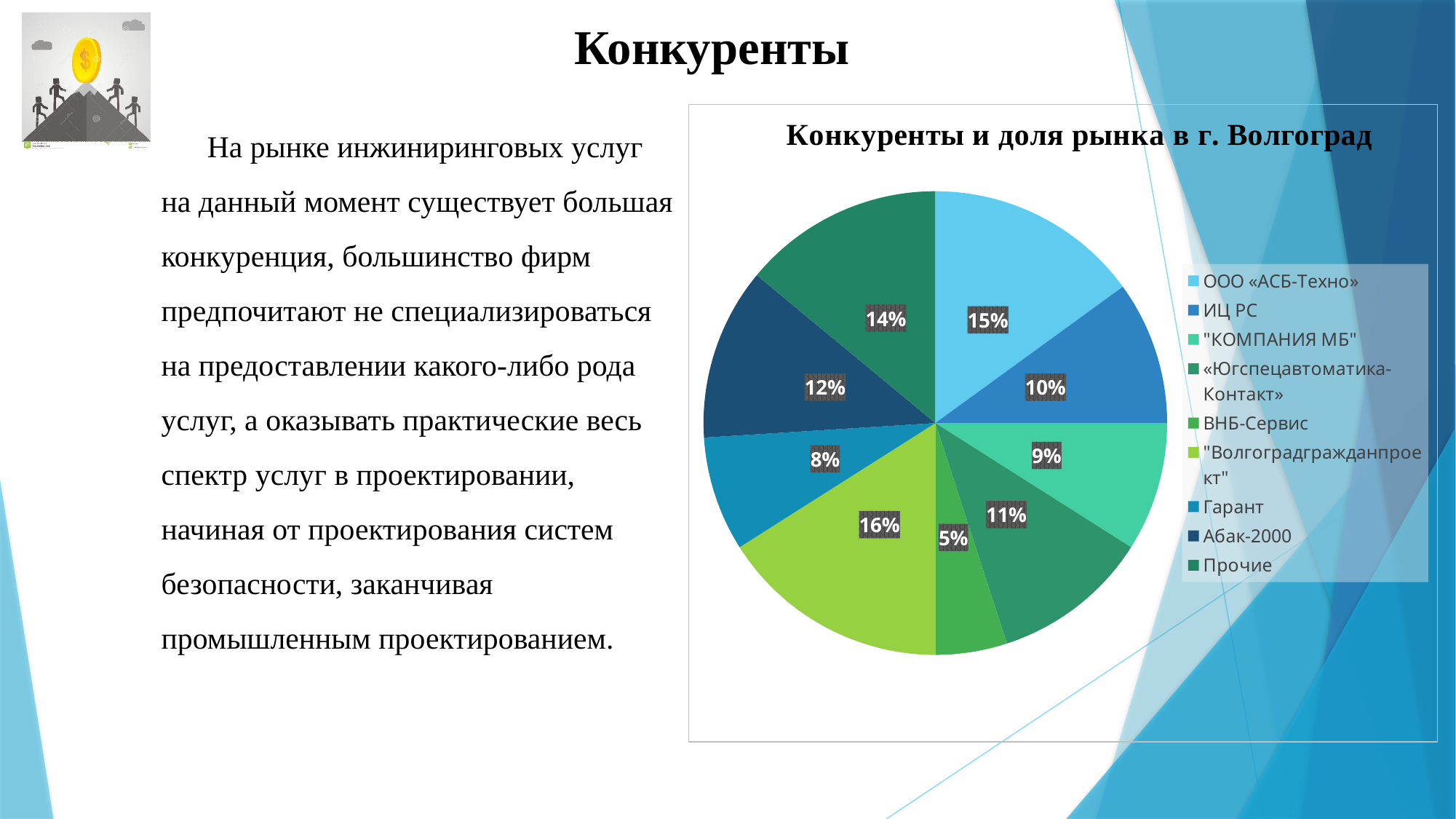
What is the market share of Абак-2000? 12% Which competitor has the largest market share? "Волгоградгражданпроект" What is the market share of "Волгоградгражданпроект"? 16% How many slices does the pie chart have? 9 What is the market share of ВНБ-Сервис? 5% What is the title of the chart? Конкуренты и доля рынка в г. Волгоград What is the difference between the shares of ООО «АСБ-Техно» and ИЦ РС? 5% What is the market share of ООО «АСБ-Техно»? 15% Which competitor has the smallest market share? ВНБ-Сервис Which has a larger share: «Югспецавтоматика-Контакт» or "КОМПАНИЯ МБ"? «Югспецавтоматика-Контакт» What is the market share of Гарант? 8% What type of chart is shown on the slide? Pie chart